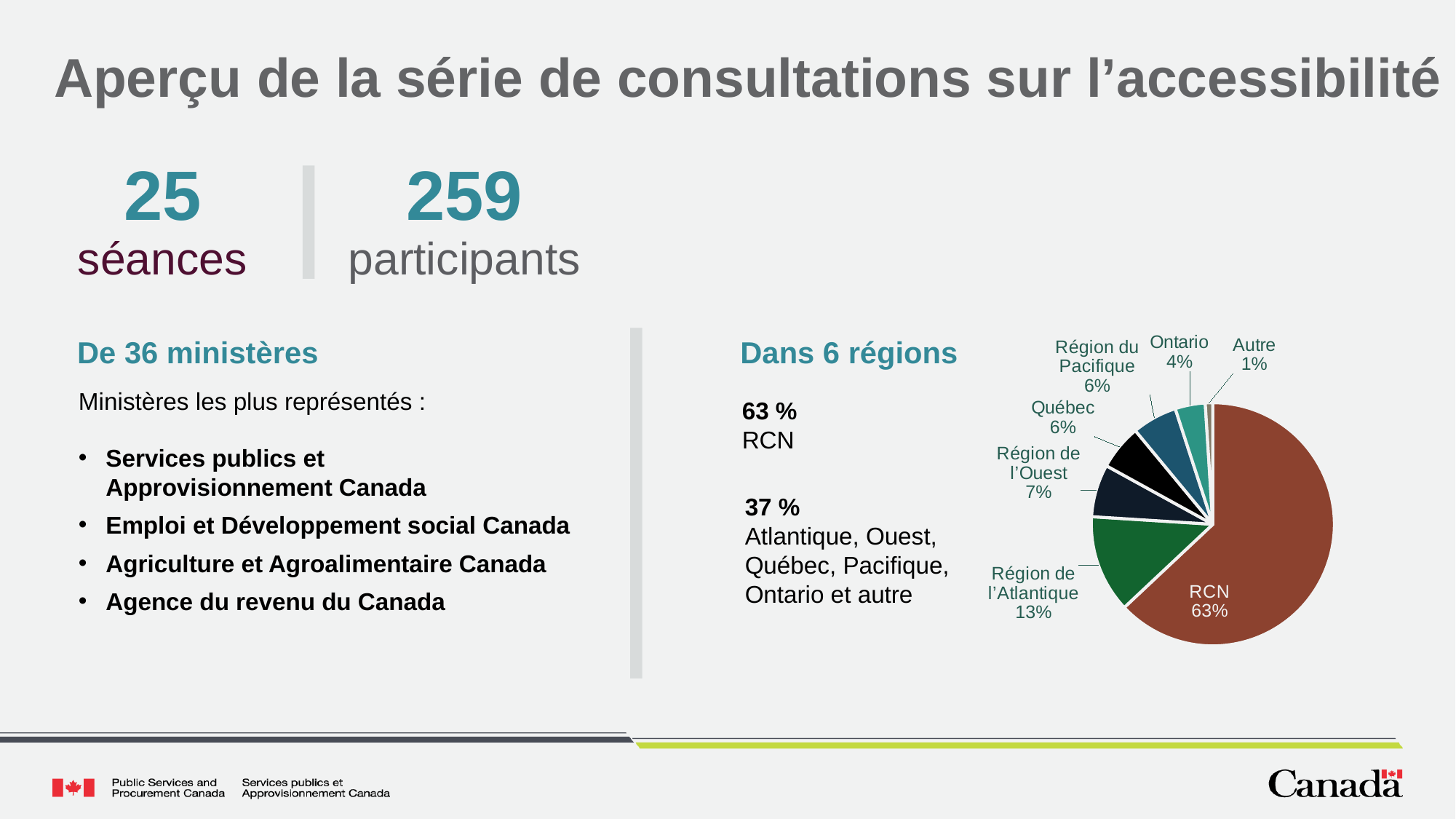
What share of the pie does Région de l'Atlantique represent? 13% What is the difference between the RCN share and the Région de l'Atlantique share? 50% What share of the pie does Québec represent? 6% How many slices does the pie chart have? 7 What share of the pie does Ontario represent? 4% What colour is the RCN slice of the pie? brown Which slice of the pie is the largest? RCN What kind of chart is shown on the slide? pie chart Which slice of the pie is the smallest? Autre Which is larger, the share for Région de l'Ouest or the share for Ontario? Région de l'Ouest